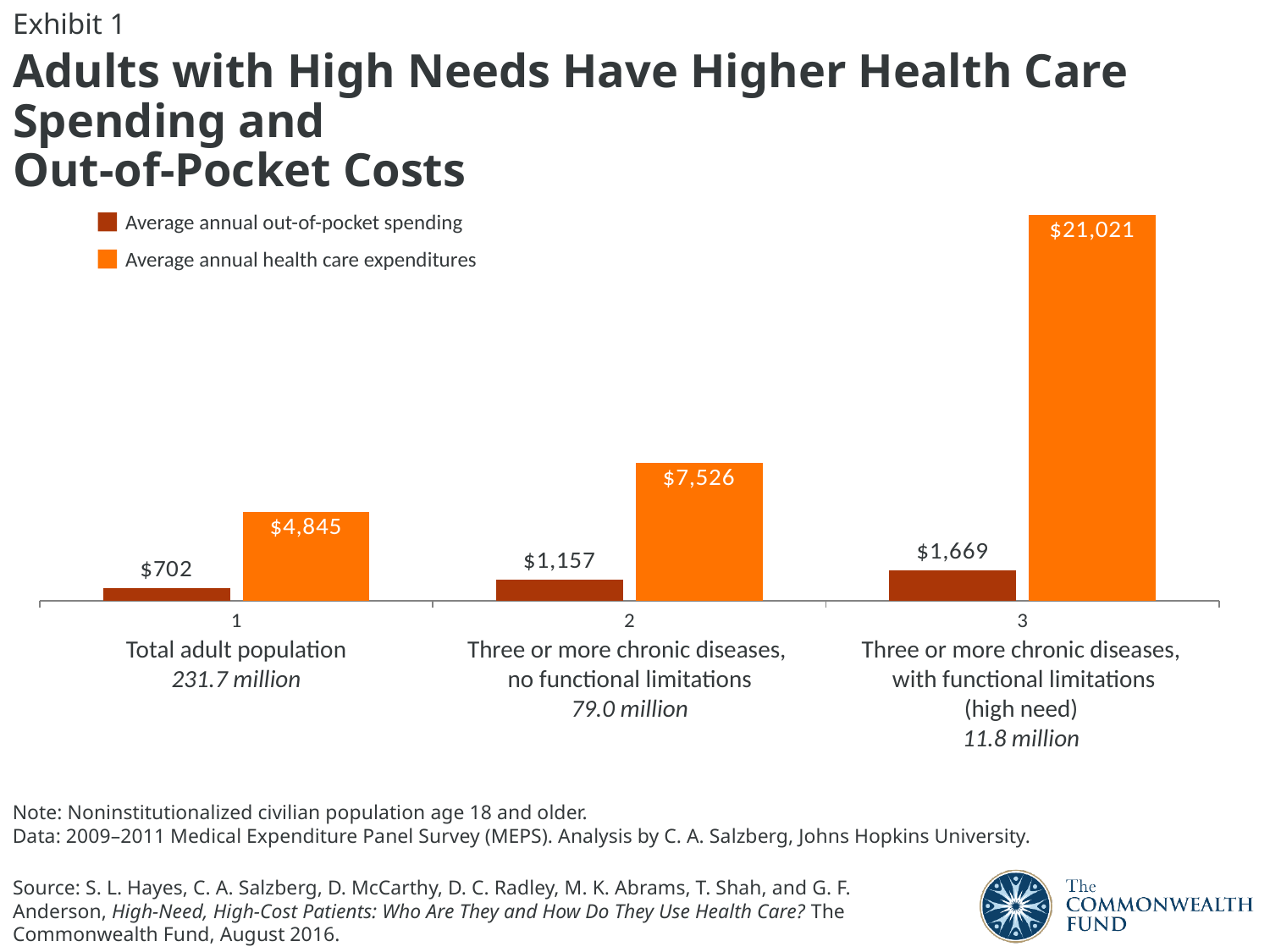
What is the average annual out-of-pocket spending for the total adult population? $702 Which is larger: the average annual health care expenditures for the total adult population or the average annual out-of-pocket spending for the high-need group? Average annual health care expenditures for the total adult population What are the average annual health care expenditures for adults with three or more chronic diseases and functional limitations (high need)? $21,021 How many population groups are shown on the chart? 3 What is the difference in average annual out-of-pocket spending between the high-need group and the group with three or more chronic diseases and no functional limitations? $512 Which group has the lowest average annual out-of-pocket spending? Total adult population Which group has the highest average annual health care expenditures? Three or more chronic diseases, with functional limitations (high need) How many series does the legend list? 2 What type of chart is shown on the slide? Bar chart What is the average annual out-of-pocket spending for adults with three or more chronic diseases, no functional limitations? $1,157 What is the difference in average annual health care expenditures between the high-need group and the total adult population? $16,176 What are the average annual health care expenditures for adults with three or more chronic diseases, no functional limitations? $7,526